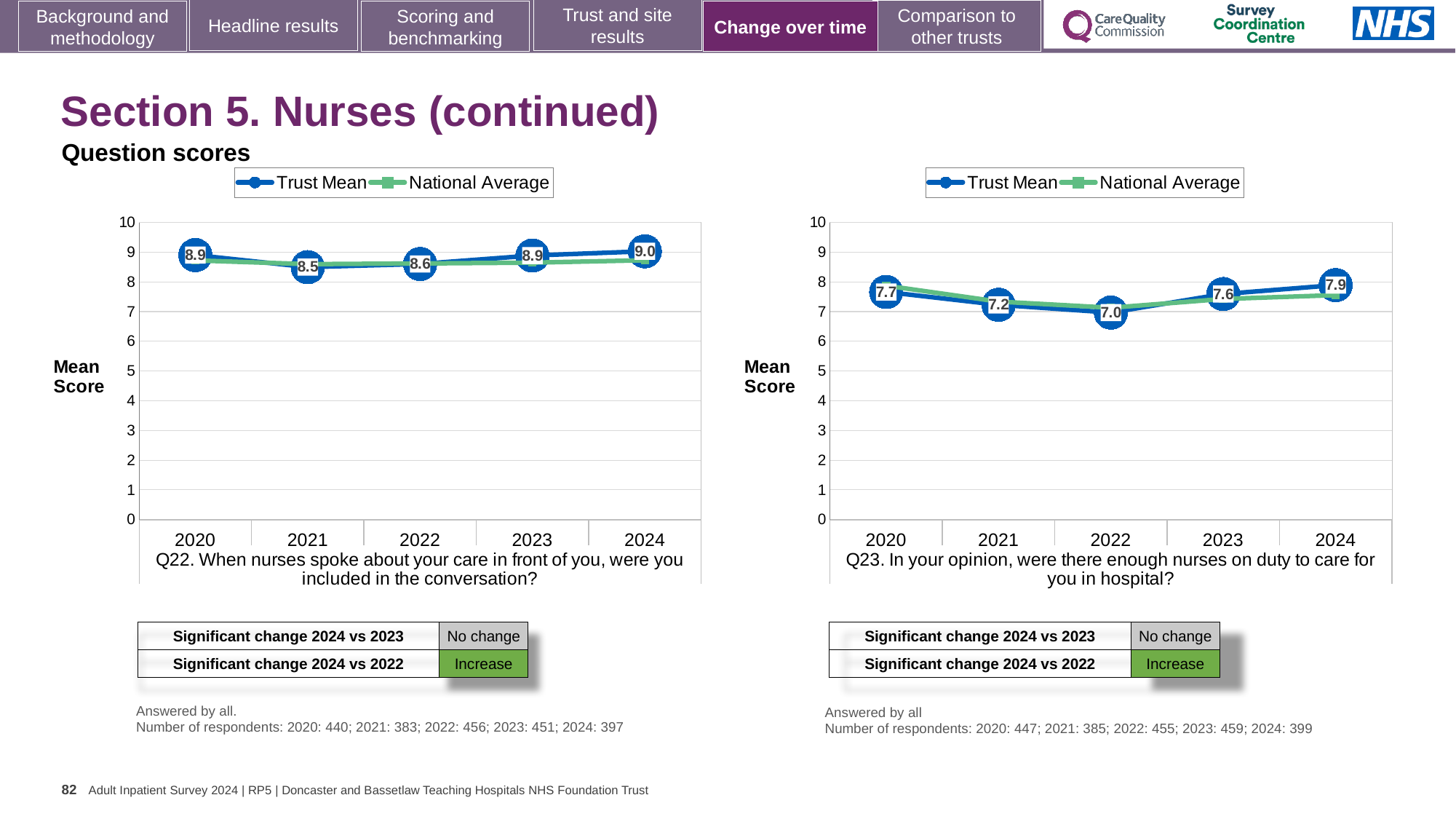
On the Q22 chart (left), what is the Trust Mean score for 2024? 9.0 On the Q23 chart (right), what is the Trust Mean score for 2020? 7.7 How many series does the legend of the Q22 chart (left) list? 2 On the Q23 chart (right), what is the Trust Mean score for 2022? 7.0 On the Q23 chart (right), what is the difference between the Trust Mean scores for 2024 and 2022? 0.9 On the Q23 chart (right), which year has the highest Trust Mean score? 2024 On the Q22 chart (left), what is the difference between the Trust Mean scores for 2024 and 2021? 0.5 What kind of chart is the Q23 chart (right)? Line chart On the Q22 chart (left), which year has the lowest Trust Mean score? 2021 On the Q22 chart (left), what is the Trust Mean score for 2021? 8.5 On the Q23 chart (right), is the Trust Mean score for 2020 greater or less than 8? less On the Q23 chart (right), which year has the lowest Trust Mean score? 2022